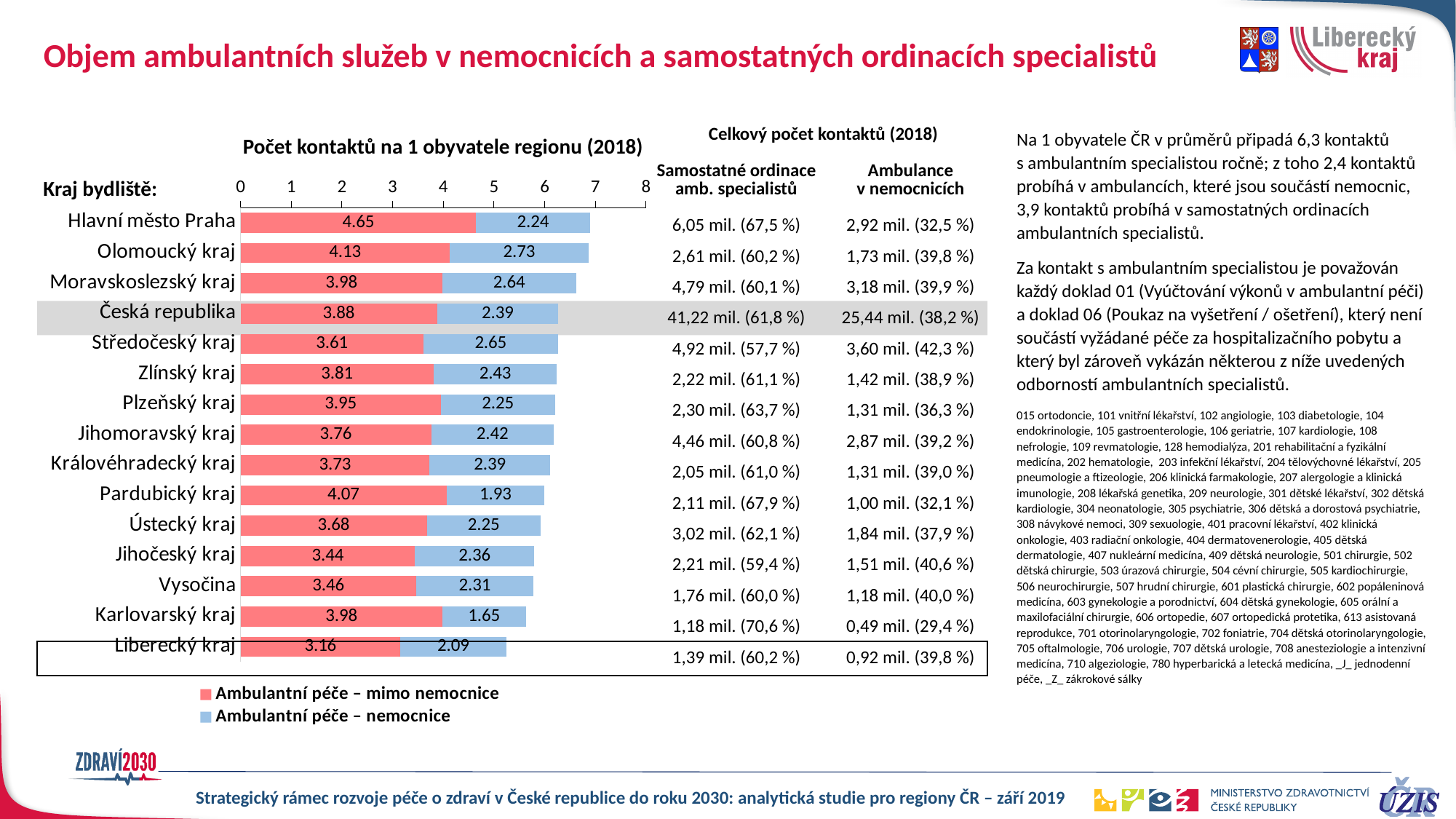
What is the difference between the 'Ambulantní péče – mimo nemocnice' values for Hlavní město Praha and Liberecký kraj? 1.49 What is the title of the chart? Počet kontaktů na 1 obyvatele regionu (2018) How many series does the chart legend list? 2 What is the value of 'Ambulantní péče – mimo nemocnice' for Liberecký kraj? 3.16 Which region has the highest value for 'Ambulantní péče – mimo nemocnice'? Hlavní město Praha How many regions (bars) are plotted in the chart? 15 What is the total number of contacts per inhabitant for Hlavní město Praha (sum of both segments)? 6.89 Which is larger: the 'Ambulantní péče – nemocnice' value for Pardubický kraj or for Karlovarský kraj? Pardubický kraj What kind of chart is shown on the slide? Stacked bar chart What is the value of 'Ambulantní péče – nemocnice' for Olomoucký kraj? 2.73 Is the total bar length for Liberecký kraj greater or less than 6? less Which region has the lowest value for 'Ambulantní péče – nemocnice'? Karlovarský kraj